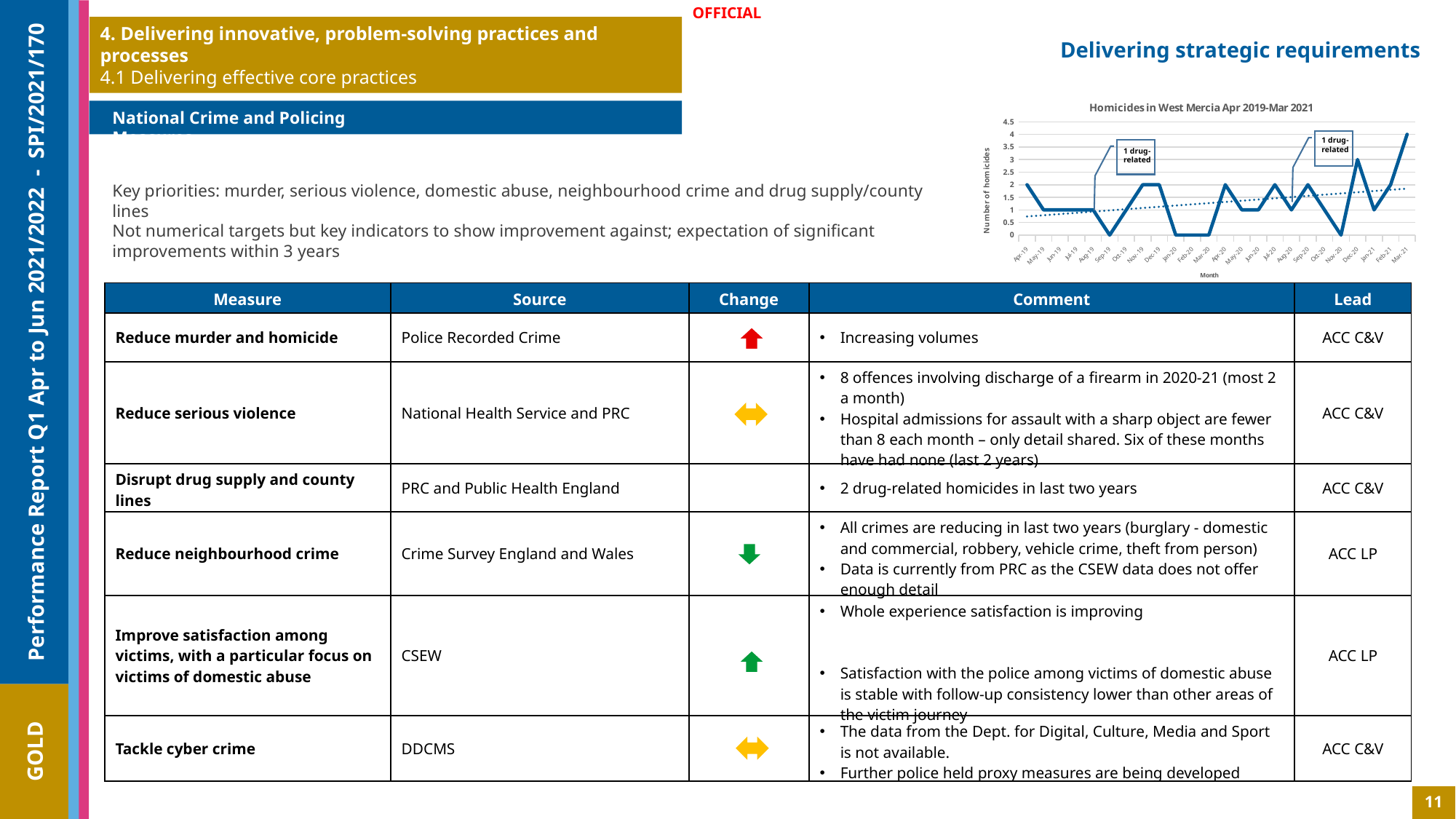
In the homicides chart, is the value for Dec-20 greater or less than 2? greater In the homicides chart, what is the number of homicides in Mar-21? 4 What is the title of the chart on the slide? Homicides in West Mercia Apr 2019-Mar 2021 In the homicides chart, which month has the highest number of homicides? Mar-21 In the homicides chart, what is the highest value shown on the y axis? 4.5 In the homicides chart, which is larger, the value for Mar-21 or the value for Dec-20? Mar-21 In the homicides chart, is the value for Mar-21 greater or less than 3? greater What type of chart is 'Homicides in West Mercia Apr 2019-Mar 2021'? line chart In the homicides chart, how many points are annotated as '1 drug-related'? 2 What is the label of the x axis in the homicides chart? Month In the homicides chart, does the dotted trend line rise or fall from Apr-19 to Mar-21? rise